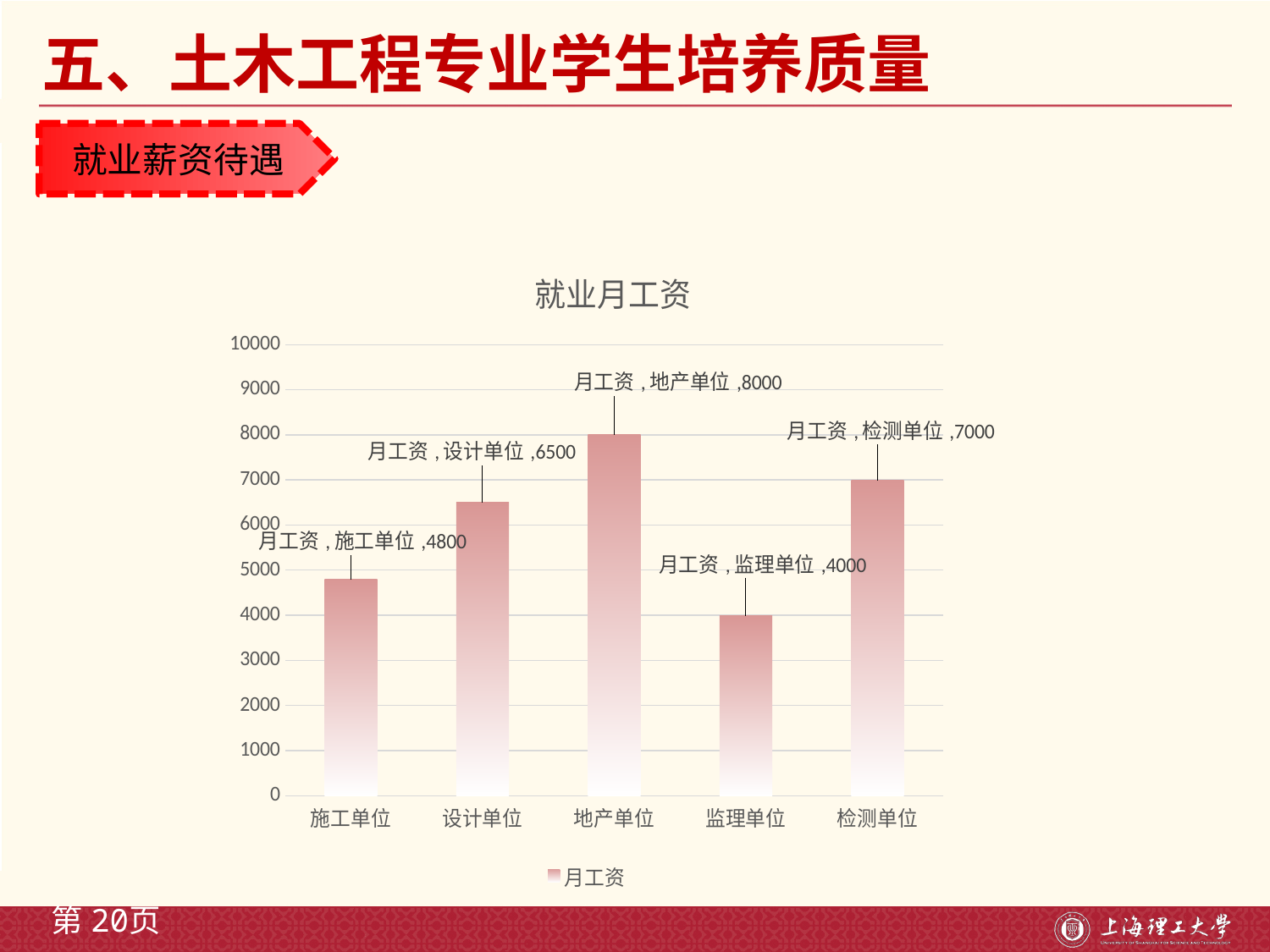
What is the monthly salary (月工资) for 监理单位? 4000 Which category has the highest monthly salary? 地产单位 Which has a higher monthly salary, 设计单位 or 检测单位? 检测单位 How many categories are shown on the x axis? 5 What is the title of the chart? 就业月工资 What is the monthly salary (月工资) for 地产单位? 8000 What is the monthly salary (月工资) for 施工单位? 4800 What type of chart is shown on the slide? bar chart What is the monthly salary (月工资) for 设计单位? 6500 What is the difference in monthly salary between 地产单位 and 监理单位? 4000 Which category has the lowest monthly salary? 监理单位 What is the monthly salary (月工资) for 检测单位? 7000